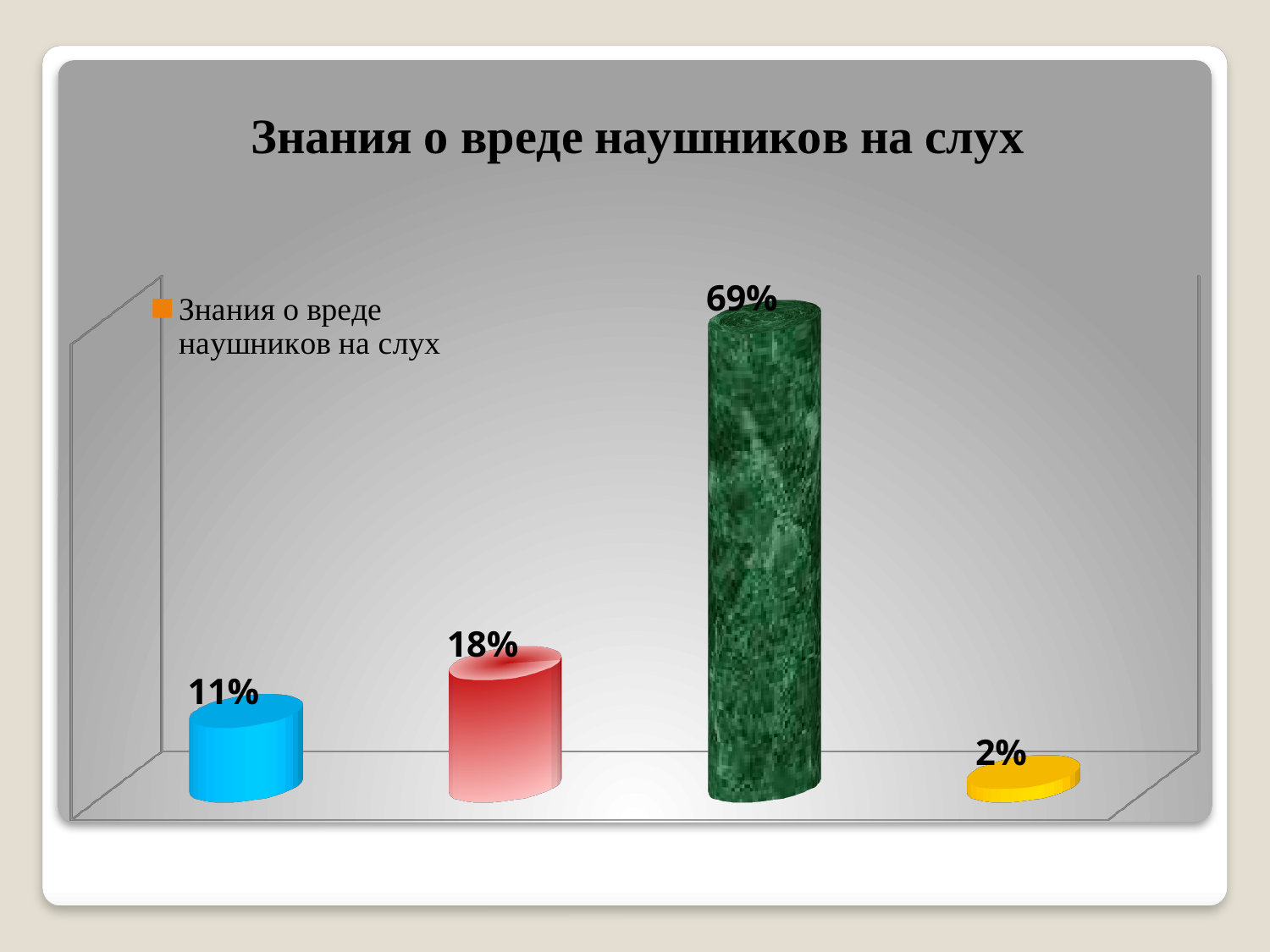
What is the difference between the green bar and the red bar? 51% What is the value shown on the blue bar (first from the left)? 11% What is the difference between the red bar and the blue bar? 7% Which bar has the lowest value? The yellow bar (2%) What is the value shown on the red bar (second from the left)? 18% How many bars are plotted in the chart? 4 What is the value shown on the green bar (third from the left)? 69% What is the value shown on the yellow bar (fourth from the left)? 2% Which bar has the highest value? The green bar (69%) What type of chart is shown on the slide? Bar chart Which is larger, the blue bar or the red bar? The red bar What is the title of the chart? Знания о вреде наушников на слух